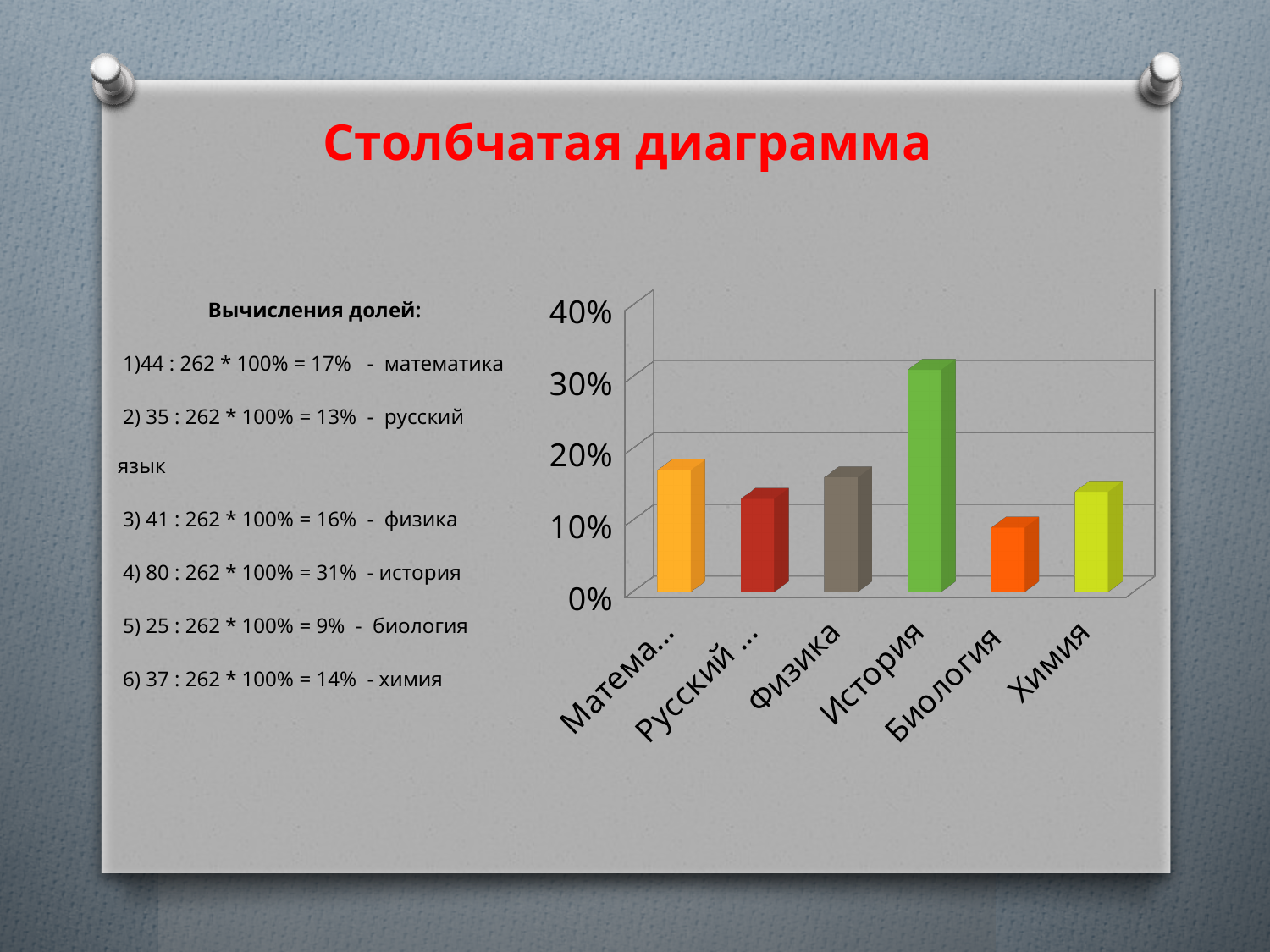
What kind of chart is shown on the slide? bar chart Which category has the lowest bar in the chart? Биология What is the title of the slide above the chart? Столбчатая диаграмма Is the value for Физика greater or less than 20%? less Is the value for История greater or less than 20%? greater Which is larger, the value for Физика or the value for Биология? Физика Which is larger, the value for История or the value for Химия? История Is the value for Биология greater or less than 20%? less What is the highest tick value shown on the chart's vertical axis? 40% How many categories (bars) does the chart show? 6 Which category has the highest bar in the chart? История